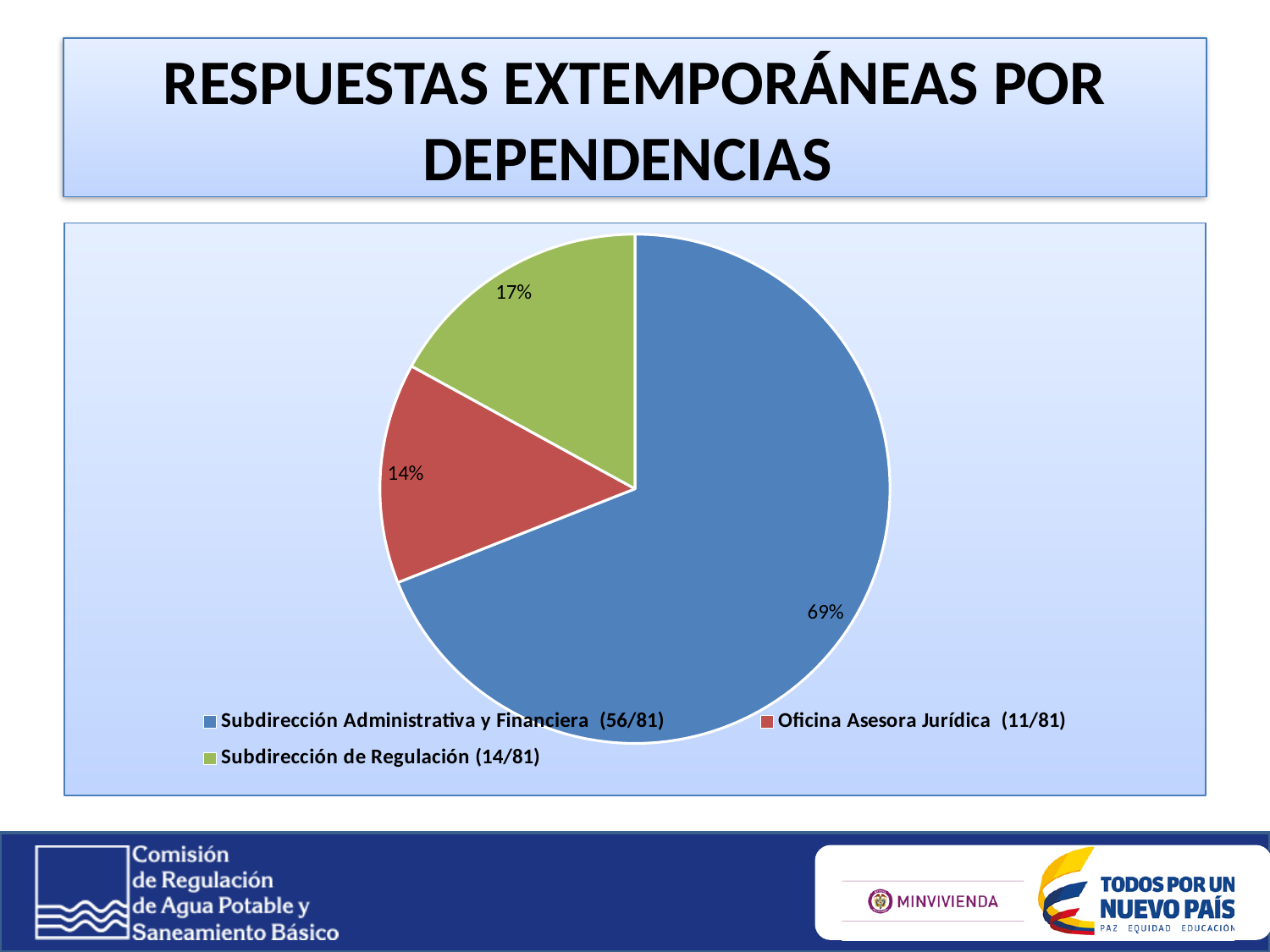
Which category has the largest slice of the pie? Subdirección Administrativa y Financiera (56/81) Which category has the smallest slice of the pie? Oficina Asesora Jurídica (11/81) What share of the pie does Oficina Asesora Jurídica (11/81) have? 14% What is the title of the slide containing the chart? RESPUESTAS EXTEMPORÁNEAS POR DEPENDENCIAS What is the difference in percentage points between the Subdirección Administrativa y Financiera slice and the Subdirección de Regulación slice? 52 What share of the pie does Subdirección de Regulación (14/81) have? 17% What kind of chart is shown on the slide? pie chart What share of the pie does Subdirección Administrativa y Financiera (56/81) have? 69% What colour is the slice for Oficina Asesora Jurídica (11/81)? red Which slice is larger, Subdirección de Regulación or Oficina Asesora Jurídica? Subdirección de Regulación How many slices does the pie chart have? 3 What is the difference in percentage points between the Subdirección de Regulación slice and the Oficina Asesora Jurídica slice? 3